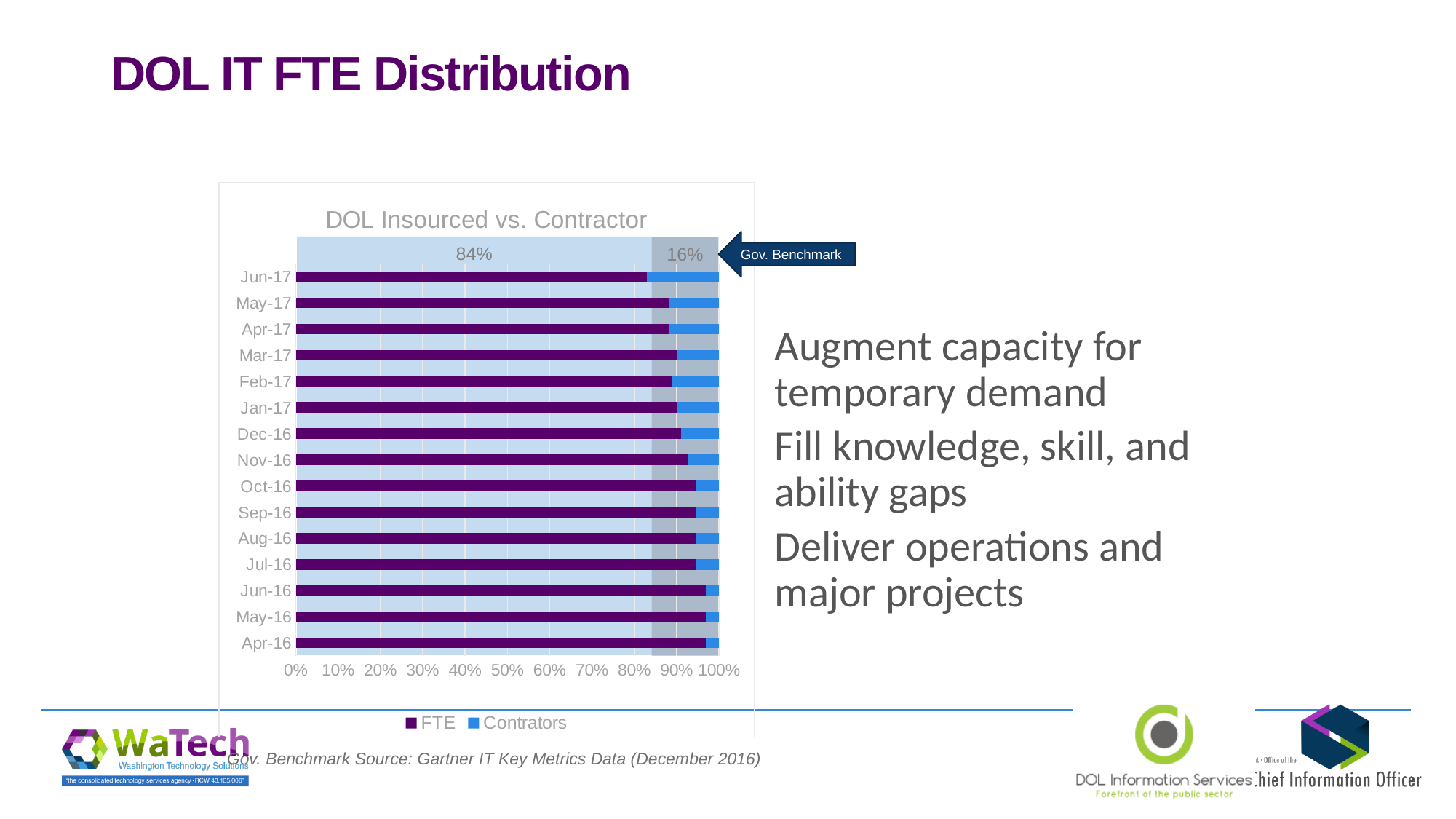
What do the FTE and Contrators segments of each bar add up to? 100% What type of chart is shown on the slide? Stacked bar chart Which month has the larger Contrators share, Jun-17 or Oct-16? Jun-17 What FTE percentage does the Gov. Benchmark band show? 84% What is the title of the chart? DOL Insourced vs. Contractor Does the FTE share rise or fall from Apr-16 to Jun-17? fall Which month has the lowest FTE share? Jun-17 Which month has the larger FTE share, Apr-16 or Jun-17? Apr-16 Is the FTE share for Apr-16 greater or less than 90%? greater Is the FTE share for Jun-17 greater or less than 90%? less How many months are plotted on the chart? 15 How many series does the chart legend list? 2